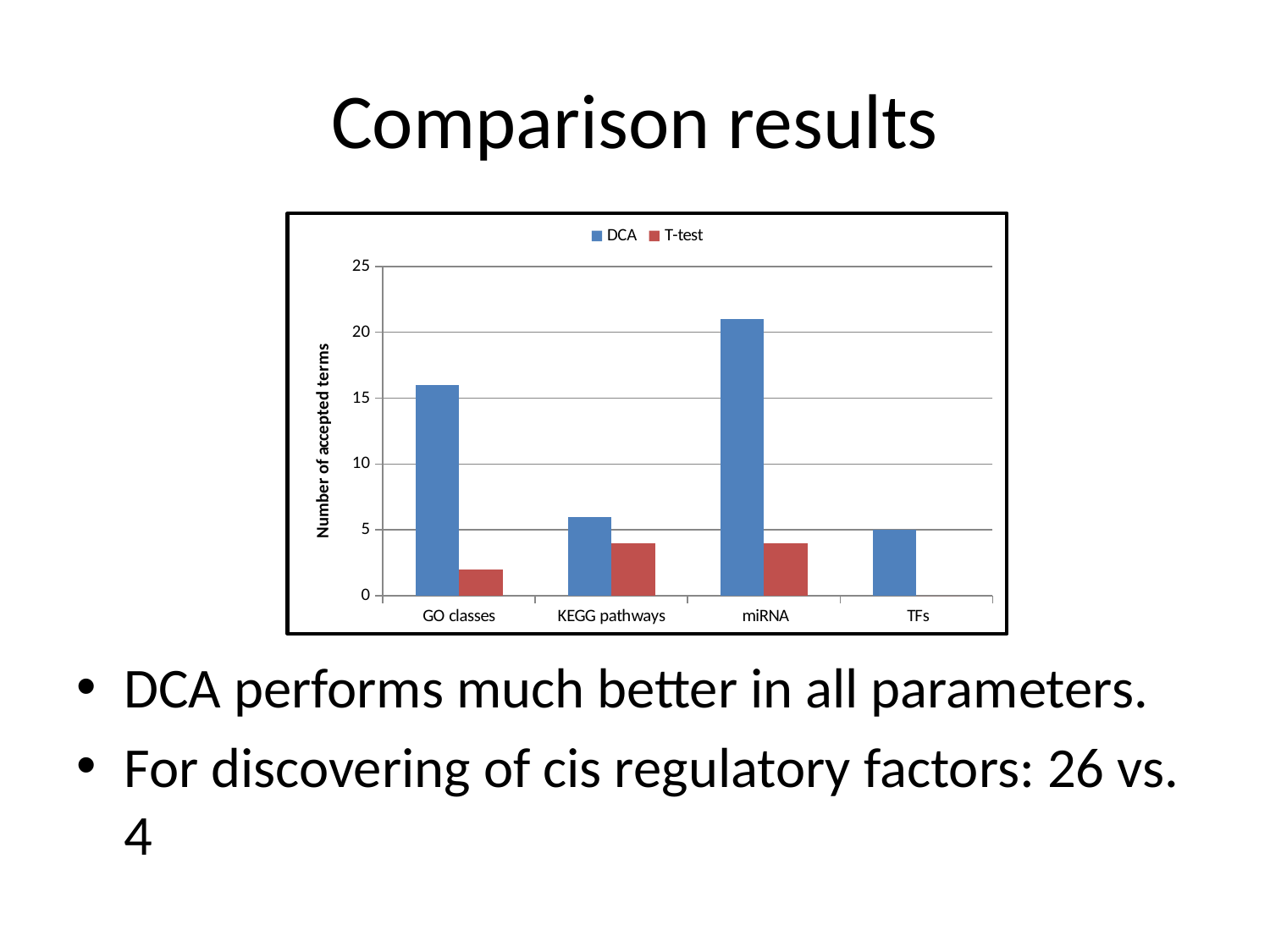
Is the T-test value for KEGG pathways greater or less than 5? less How many categories are shown on the x axis? 4 How many series does the legend list? 2 What is the label of the y axis? Number of accepted terms Which series is shown in red? T-test Is the DCA value for miRNA greater or less than 20? greater Which category has the lowest DCA value? TFs Which category has the highest DCA value? miRNA What kind of chart is shown on the slide? bar chart Is the DCA value for KEGG pathways greater or less than 5? greater Which is larger for GO classes, the DCA value or the T-test value? DCA